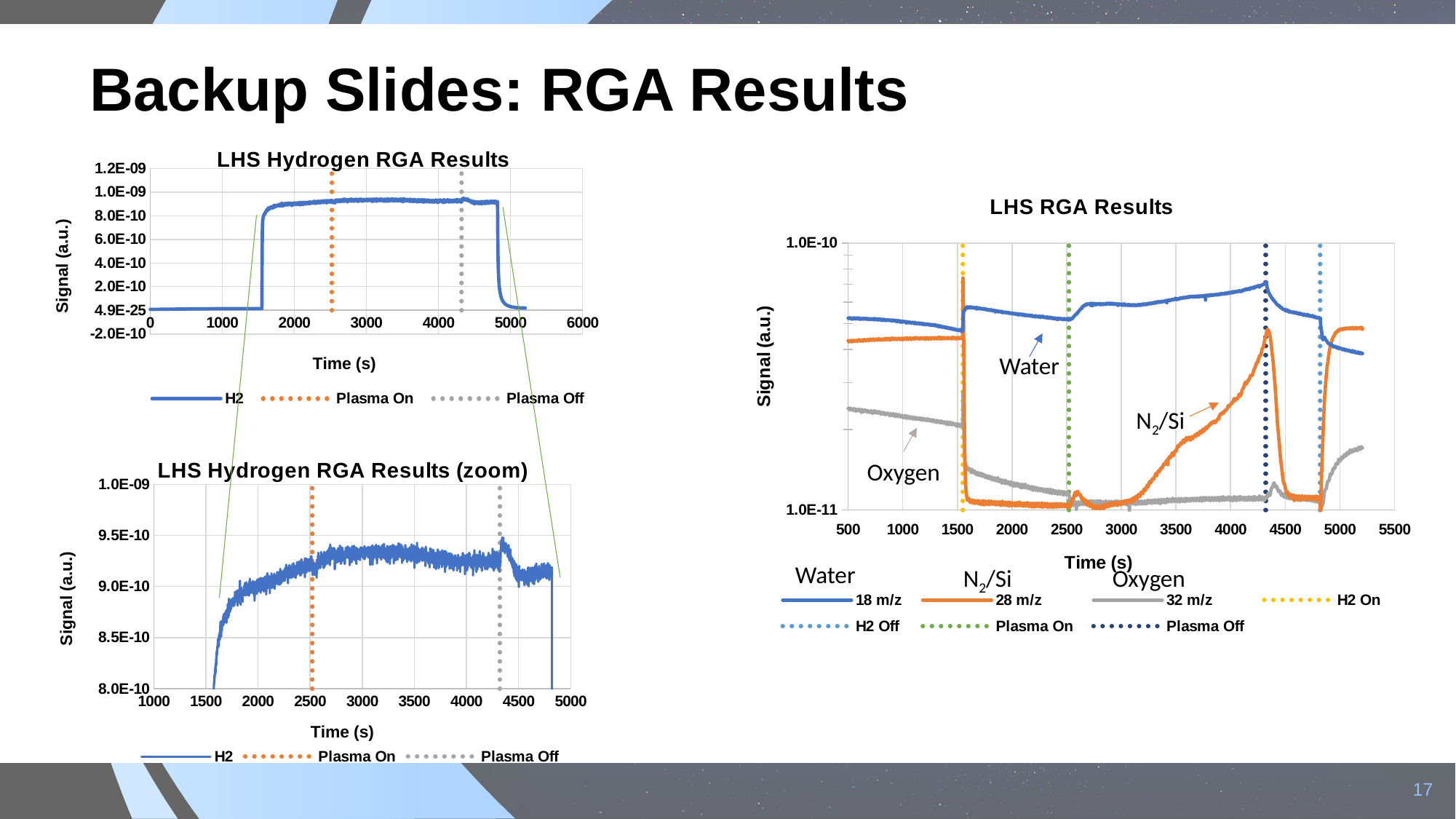
How many entries does the legend of the "LHS RGA Results" chart on the right list? 7 In the "LHS RGA Results" chart on the right, does the 28 m/z series rise or fall between time 3000 and time 4300? rise In the "LHS RGA Results" chart on the right, which series is higher at time 3000, 18 m/z or 28 m/z? 18 m/z What kind of chart is the "LHS Hydrogen RGA Results" chart at the top left? line chart In the "LHS Hydrogen RGA Results" chart at the top left, is the H2 value at time 1000 greater or less than 2.0E-10? less In the "LHS Hydrogen RGA Results (zoom)" chart at the bottom left, is the H2 value at time 3000 greater or less than 9.0E-10? greater In the "LHS Hydrogen RGA Results" chart at the top left, is the H2 value at time 3000 greater or less than 6.0E-10? greater What is the x-axis label of the "LHS RGA Results" chart on the right? Time (s) In the "LHS RGA Results" chart on the right, which series is higher at time 1000, 18 m/z or 32 m/z? 18 m/z In the "LHS Hydrogen RGA Results" chart at the top left, does the H2 series rise or fall between time 4800 and time 5000? fall What is the y-axis label of the "LHS Hydrogen RGA Results (zoom)" chart at the bottom left? Signal (a.u.) How many entries does the legend of the "LHS Hydrogen RGA Results" chart at the top left list? 3